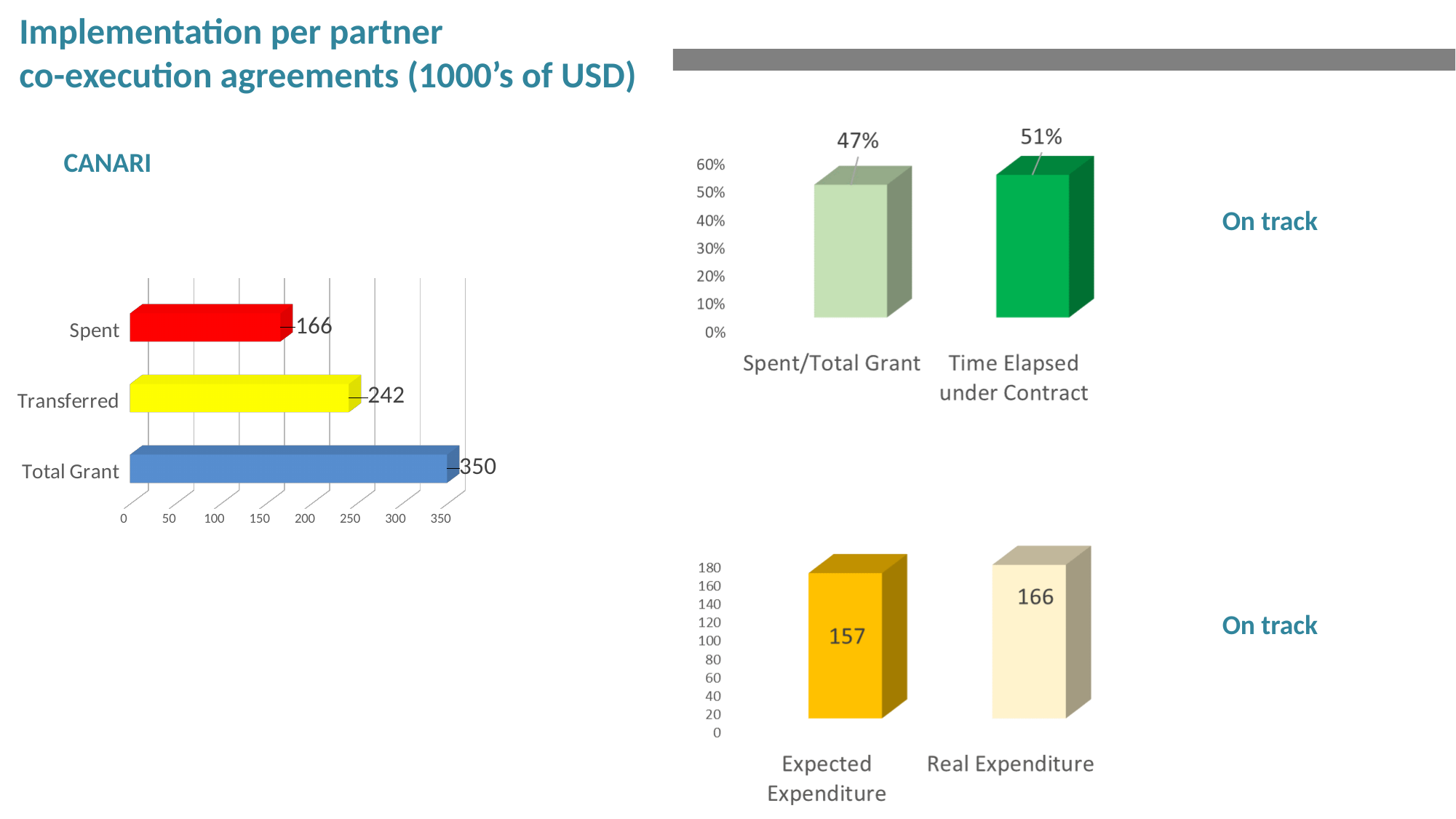
In the top-right chart, which is larger: Spent/Total Grant or Time Elapsed under Contract? Time Elapsed under Contract In the CANARI bar chart on the left, what is the value for Transferred? 242 In the CANARI bar chart on the left, which category has the lowest value? Spent In the CANARI bar chart on the left, how many categories are shown? 3 In the top-right chart, what is the value for Time Elapsed under Contract? 51% In the CANARI bar chart on the left, what is the value for Spent? 166 What kind of chart is the CANARI chart on the left? Bar chart In the CANARI bar chart on the left, which category has the highest value? Total Grant In the top-right chart, what is the value for Spent/Total Grant? 47% In the CANARI bar chart on the left, what is the difference between Total Grant and Transferred? 108 In the bottom-right chart, what is the difference between Real Expenditure and Expected Expenditure? 9 In the bottom-right chart, what is the value for Expected Expenditure? 157